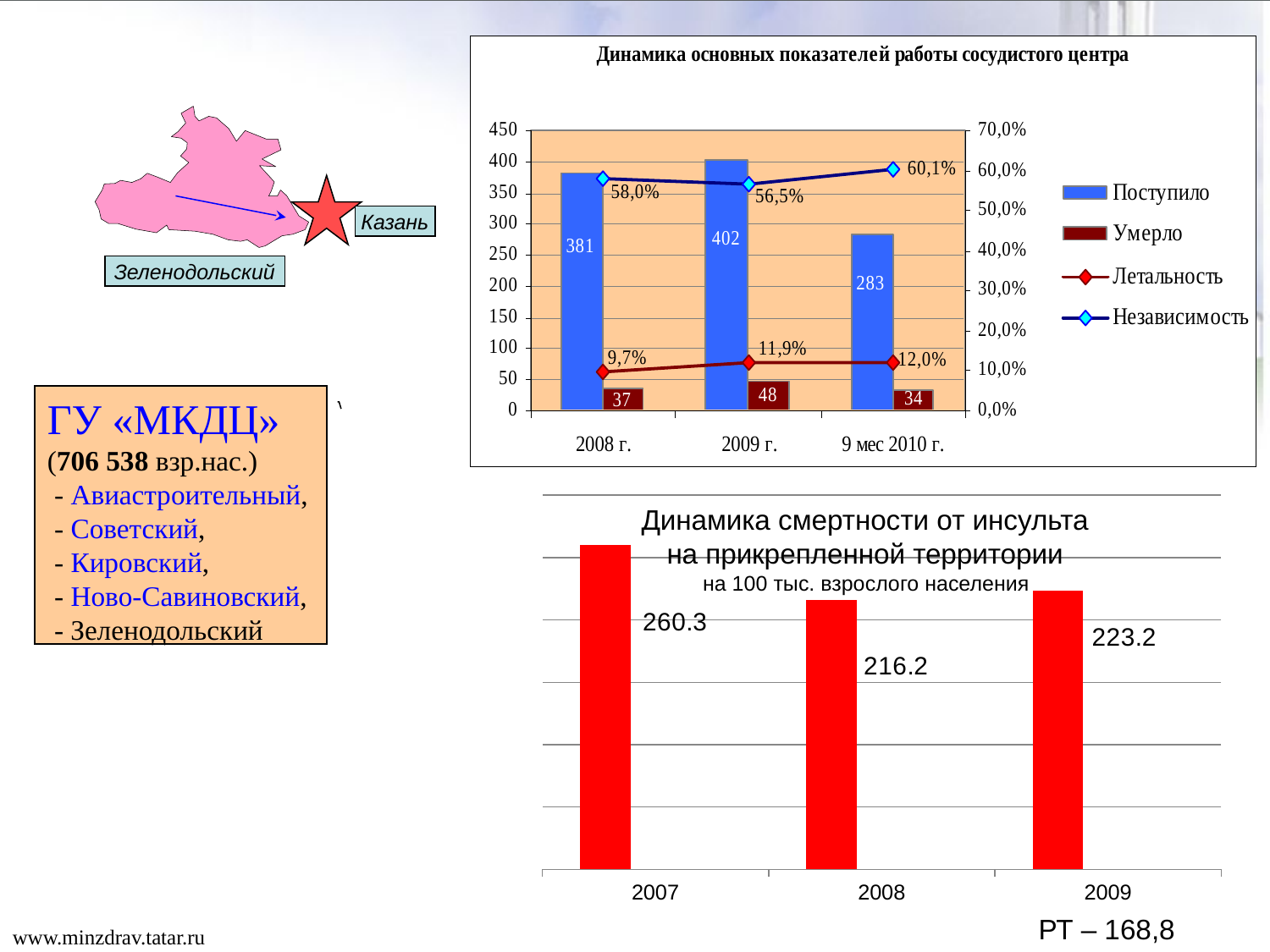
What kind of chart is the bottom chart 'Динамика смертности от инсульта на прикрепленной территории'? Bar chart In the chart 'Динамика основных показателей работы сосудистого центра', what is the Летальность value for 9 мес 2010 г.? 12,0% In the chart 'Динамика основных показателей работы сосудистого центра', which period has the highest Поступило value? 2009 г. In the chart 'Динамика основных показателей работы сосудистого центра', what is the value of Умерло for 2008 г.? 37 In the chart 'Динамика смертности от инсульта на прикрепленной территории', what is the difference between the 2007 and 2009 values? 37.1 In the chart 'Динамика смертности от инсульта на прикрепленной территории', what is the value for 2008? 216.2 In the chart 'Динамика основных показателей работы сосудистого центра', what is the value of Поступило for 2009 г.? 402 In the chart 'Динамика основных показателей работы сосудистого центра', what is the difference between Поступило in 2009 г. and 9 мес 2010 г.? 119 How many series does the legend of the chart 'Динамика основных показателей работы сосудистого центра' list? 4 In the chart 'Динамика основных показателей работы сосудистого центра', which period has the lowest Умерло value? 9 мес 2010 г. In the chart 'Динамика смертности от инсульта на прикрепленной территории', which year has the highest value? 2007 In the chart 'Динамика основных показателей работы сосудистого центра', what is the Независимость value for 2009 г.? 56,5%